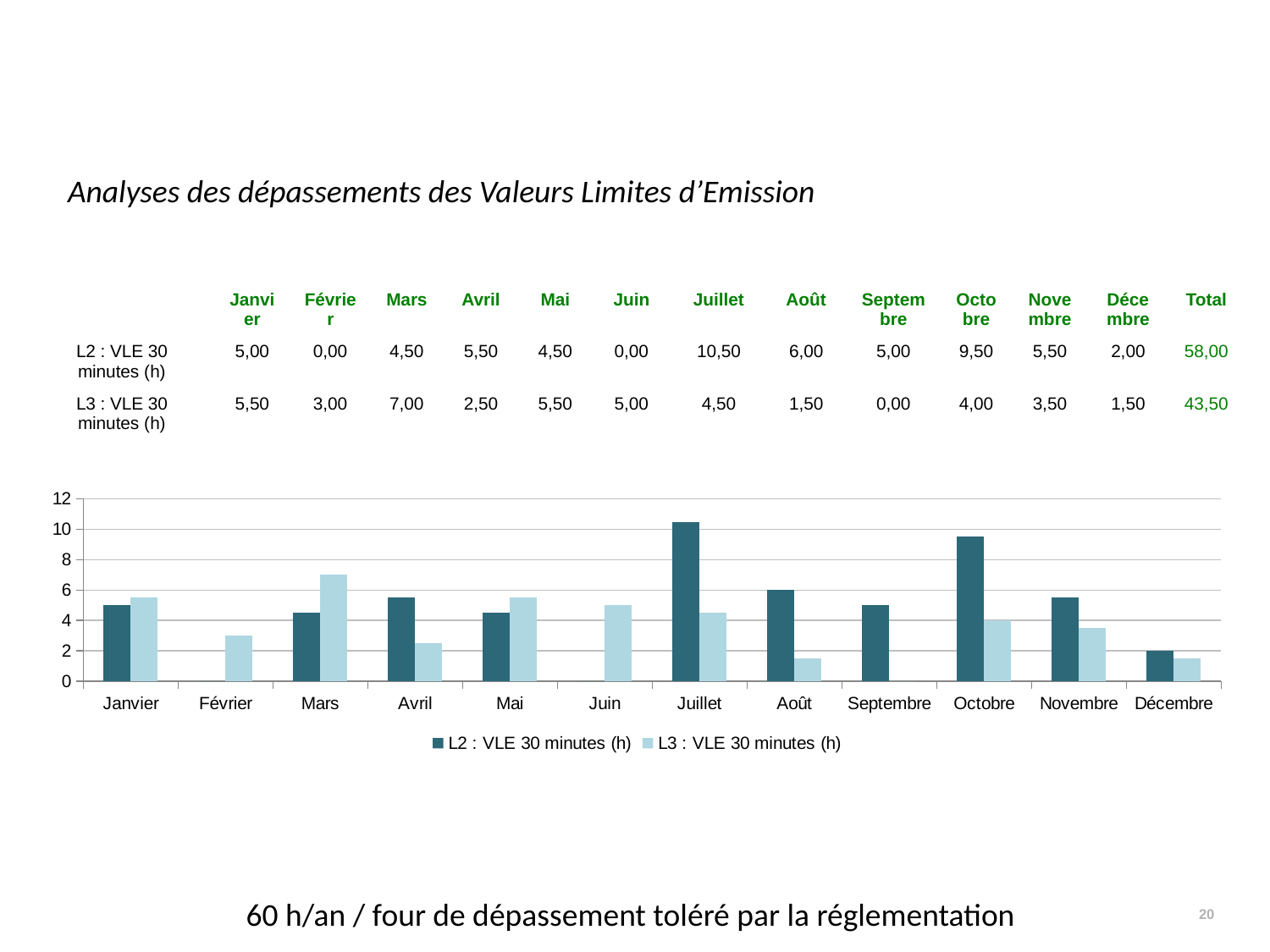
What is the total for L3 : VLE 30 minutes (h) shown in the table? 43,50 What is the value for L2 : VLE 30 minutes (h) in Juillet? 10,50 What is the difference between the L2 and L3 values in Octobre? 5,50 What kind of chart is shown on the slide? Bar chart How many months are shown on the x axis of the chart? 12 How many series does the chart legend list? 2 Which month has the lowest value for L3 : VLE 30 minutes (h)? Septembre In Mars, which series has the larger value, L2 : VLE 30 minutes (h) or L3 : VLE 30 minutes (h)? L3 : VLE 30 minutes (h) What is the value for L3 : VLE 30 minutes (h) in Mars? 7,00 Is the value for L2 : VLE 30 minutes (h) in Octobre greater or less than 8? greater Which series is shown in the darker colour in the chart? L2 : VLE 30 minutes (h) Which month has the highest value for L2 : VLE 30 minutes (h)? Juillet